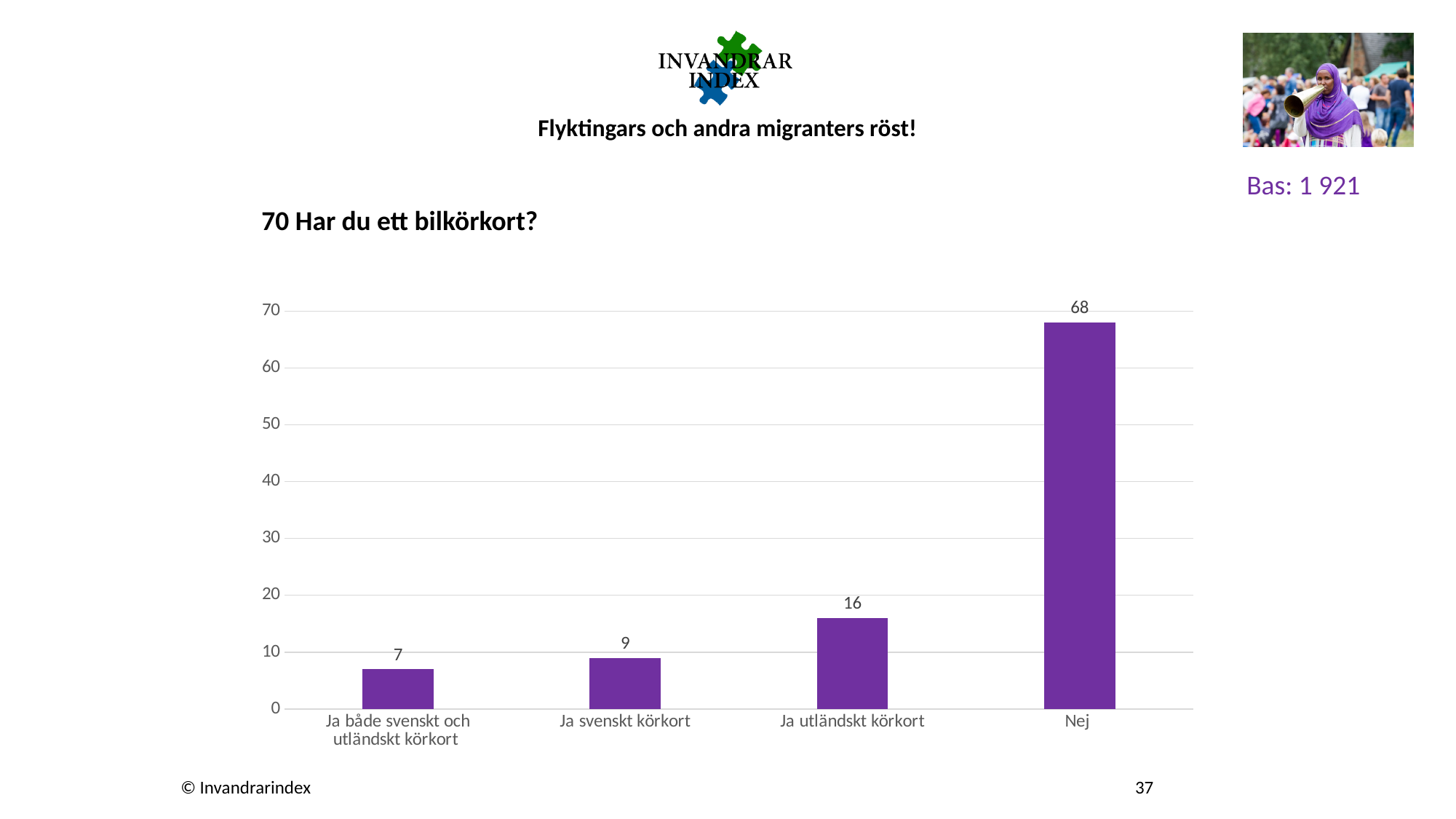
What is the difference between the values for "Nej" and "Ja utländskt körkort"? 52 What is the value for "Ja utländskt körkort"? 16 Which category has the lowest value? Ja både svenskt och utländskt körkort Which category has the highest value? Nej What is the value for "Ja både svenskt och utländskt körkort"? 7 What is the title of the chart? 70 Har du ett bilkörkort? How many categories are shown on the x axis? 4 Which is larger, the value for "Ja svenskt körkort" or "Ja utländskt körkort"? Ja utländskt körkort What is the value for "Nej"? 68 What kind of chart is shown on the slide? bar chart What is the value for "Ja svenskt körkort"? 9 Is the value for "Nej" greater or less than 60? greater